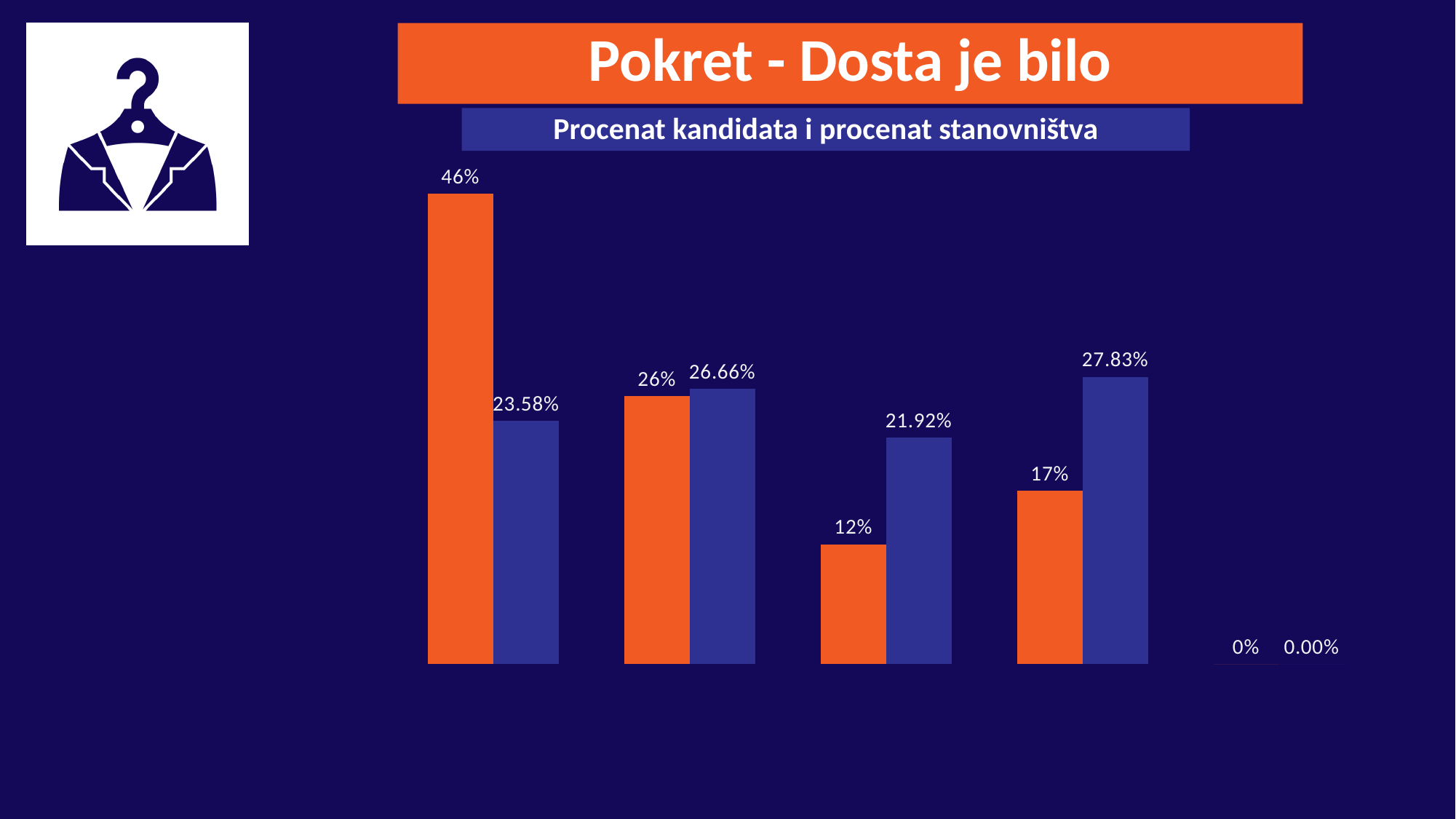
What is the value of the orange bar in the third group from the left? 12% What is the value of the blue bar in the first (leftmost) group? 23.58% What is the value of the blue bar in the fourth group from the left? 27.83% Which blue bar has the highest value? the fourth group, 27.83% Which orange bar has the highest value? the first (leftmost) group, 46% How many groups of bars are plotted in the chart? 5 What is the title shown above the chart? Pokret - Dosta je bilo In the first (leftmost) group, which bar is larger, the orange or the blue one? orange What is the difference between the blue bar (21.92%) and the orange bar (12%) in the third group? 9.92% What is the value of the orange bar in the first (leftmost) group? 46% What is the subtitle of the chart? Procenat kandidata i procenat stanovništva What kind of chart is shown on the slide? bar chart